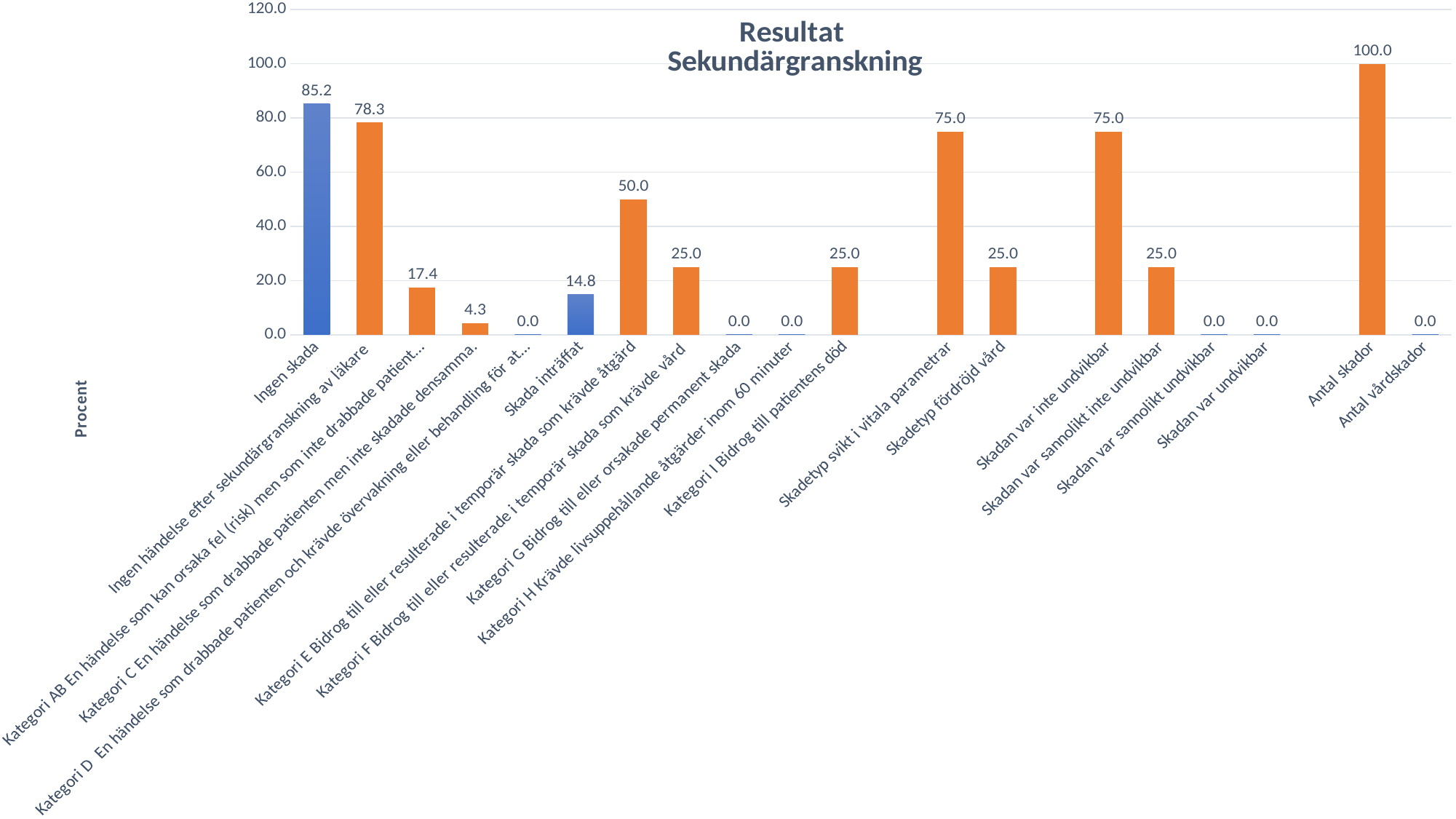
What is the value for "Ingen skada"? 85.2 How many categories are shown on the x axis? 19 What is the value for "Antal vårdskador"? 0.0 What is the title of the chart? Resultat Sekundärgranskning What kind of chart is shown on the slide? Bar chart What is the value for "Skadetyp svikt i vitala parametrar"? 75.0 Which is larger, the value for "Kategori E Bidrog till eller resulterade i temporär skada som krävde åtgärd" or the value for "Kategori F Bidrog till eller resulterade i temporär skada som krävde vård"? Kategori E Bidrog till eller resulterade i temporär skada som krävde åtgärd What is the value for "Ingen händelse efter sekundärgranskning av läkare"? 78.3 What is the difference between the values for "Ingen skada" and "Skada inträffat"? 70.4 What is the value for "Skada inträffat"? 14.8 Which category has the highest value? Antal skador What is the difference between the values for "Skadan var inte undvikbar" and "Skadan var sannolikt inte undvikbar"? 50.0